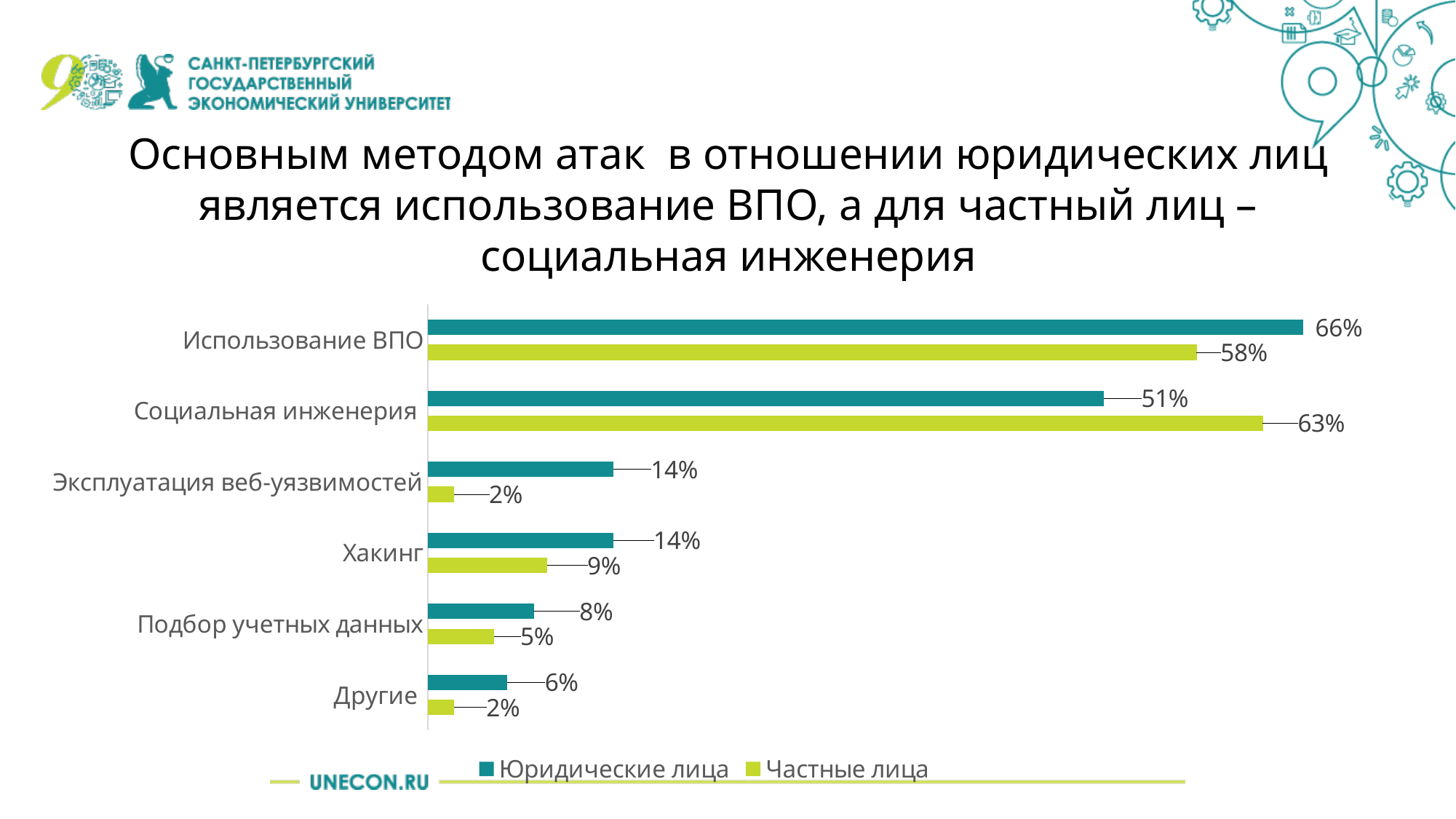
Which category has the lowest value for Юридические лица? Другие Which category has the highest value for Юридические лица? Использование ВПО Which is larger in the Подбор учетных данных category: Юридические лица or Частные лица? Юридические лица Which category has the highest value for Частные лица? Социальная инженерия How many categories are shown on the chart? 6 What is the difference between Частные лица and Юридические лица in the Социальная инженерия category? 12% What kind of chart is shown on the slide? Bar chart What is the difference between Юридические лица and Частные лица in the Хакинг category? 5% How many series does the legend list? 2 What is the value for Частные лица in the Социальная инженерия category? 63% What is the value for Юридические лица in the Использование ВПО category? 66% What is the value for Частные лица in the Эксплуатация веб-уязвимостей category? 2%